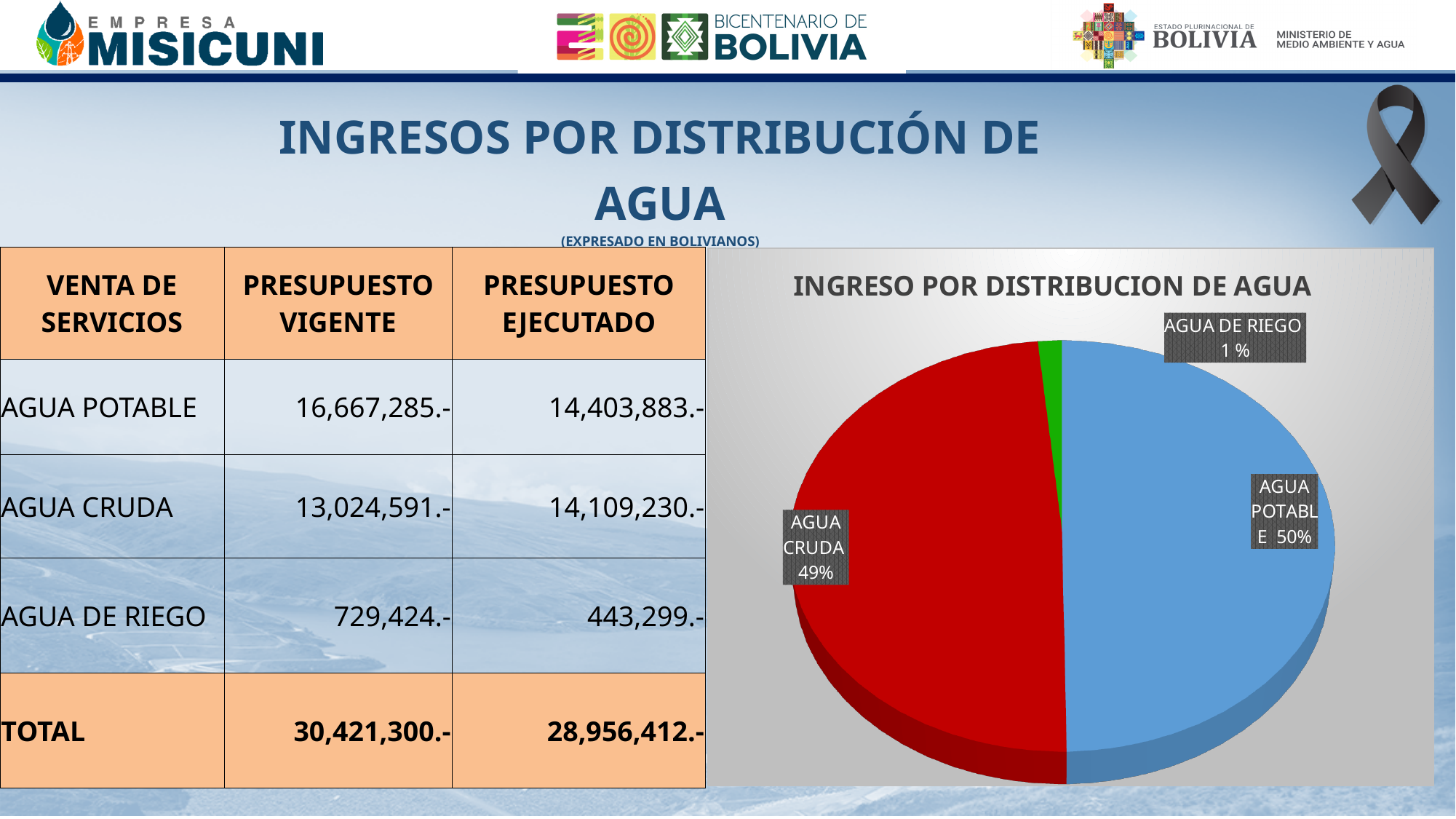
In the pie chart, what share does AGUA DE RIEGO have? 1 % What kind of chart is shown on the right side of the slide? Pie chart In the pie chart, what share does AGUA POTABLE have? 50% What is the title of the pie chart? INGRESO POR DISTRIBUCION DE AGUA How many slices does the pie chart have? 3 In the pie chart, which has the larger share, AGUA CRUDA or AGUA DE RIEGO? AGUA CRUDA In the pie chart, by how many percentage points does the AGUA CRUDA share exceed the AGUA DE RIEGO share? 48 percentage points Which slice of the pie chart is the largest? AGUA POTABLE Which slice of the pie chart is the smallest? AGUA DE RIEGO What colour is the AGUA CRUDA slice in the pie chart? Red In the pie chart, what share does AGUA CRUDA have? 49% In the pie chart, which has the larger share, AGUA POTABLE or AGUA CRUDA? AGUA POTABLE